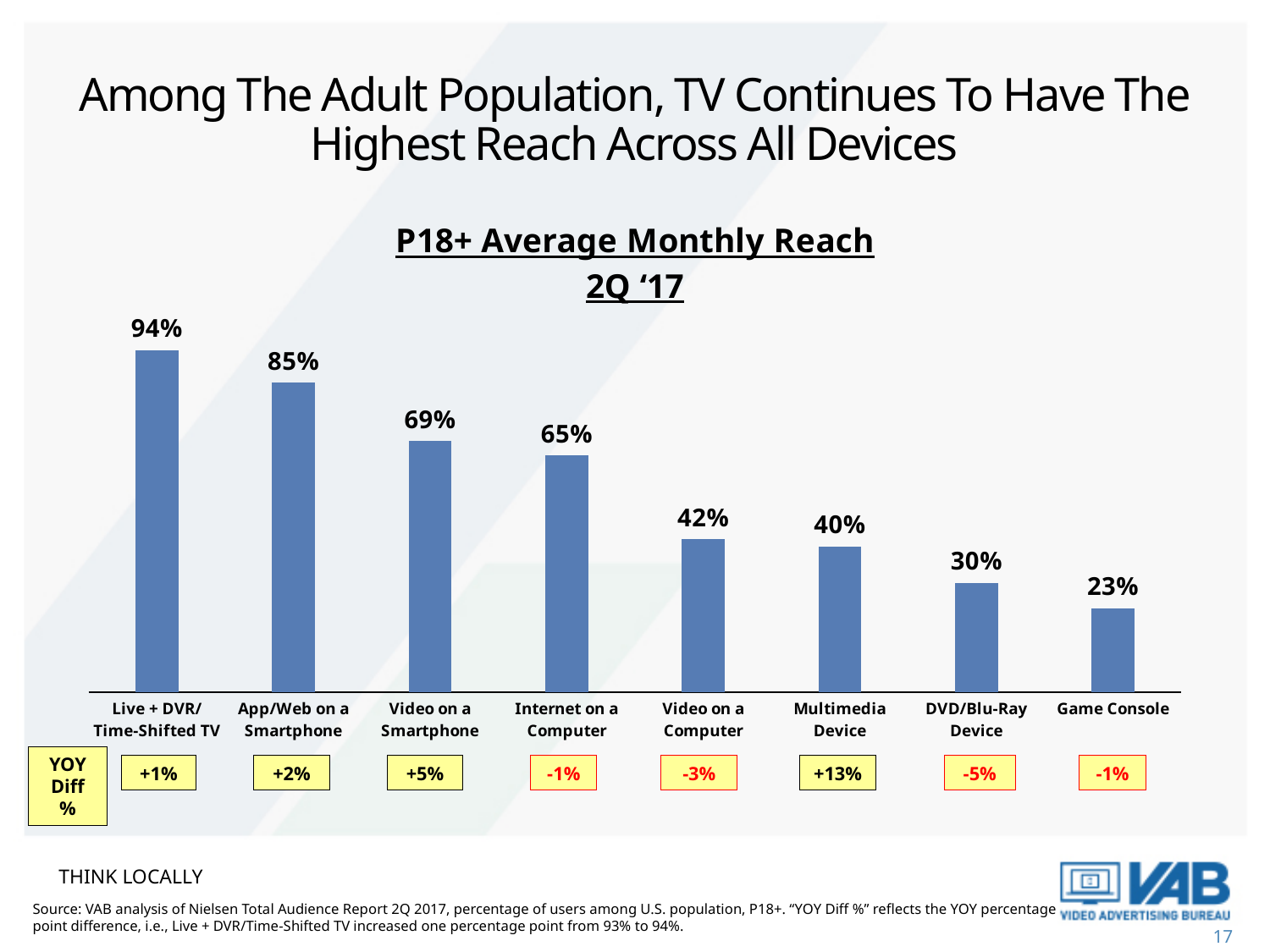
What is the average monthly reach for Multimedia Device? 40% What is the average monthly reach for Video on a Smartphone? 69% What is the P18+ average monthly reach for Live + DVR/Time-Shifted TV? 94% What is the title of the chart? P18+ Average Monthly Reach 2Q '17 Do the reach values rise or fall moving from left to right across the categories? Fall How many device categories are shown in the chart? 8 Which device category has the lowest average monthly reach? Game Console Which has a higher average monthly reach, Video on a Computer or DVD/Blu-Ray Device? Video on a Computer What is the difference in average monthly reach between App/Web on a Smartphone and Internet on a Computer? 20% What type of chart is used to show the P18+ average monthly reach? Bar chart Which device category has the highest average monthly reach? Live + DVR/Time-Shifted TV What is the YOY Diff % shown for Multimedia Device? +13%